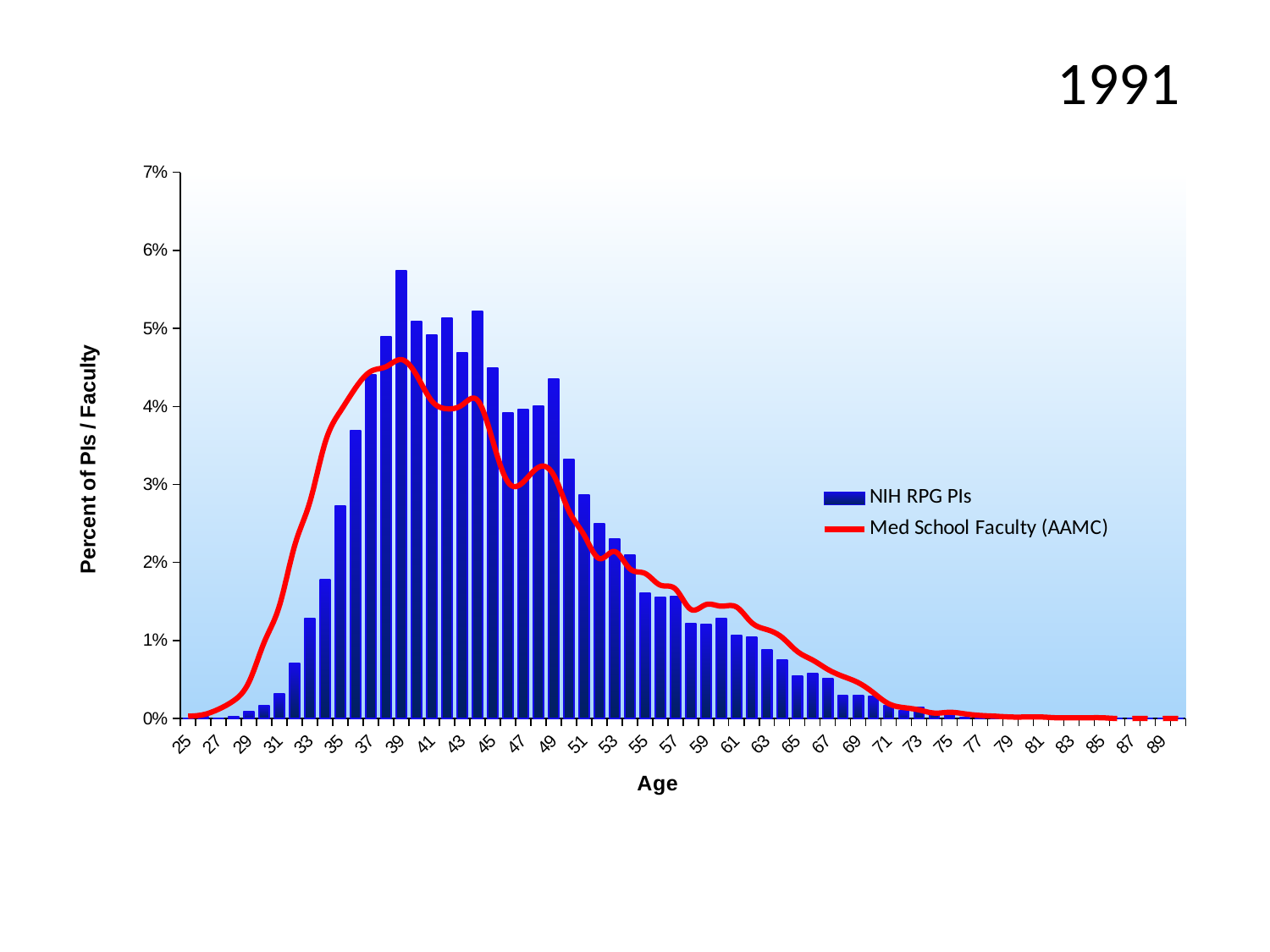
Is the NIH RPG PIs value at age 65 greater or less than 1%? less Which is larger, the NIH RPG PIs bar at age 39 or at age 49? Age 39 Is the Med School Faculty (AAMC) value at age 31 greater or less than 2%? less Do the NIH RPG PIs values rise or fall from age 49 to age 69? Fall At which age is the NIH RPG PIs bar highest? 39 What is the title of the x axis? Age How many series does the legend list? 2 Is the NIH RPG PIs value at age 35 greater or less than 3%? less Which is larger, the NIH RPG PIs bar at age 35 or at age 45? Age 45 What kind of chart is shown on the slide? Bar chart with a line overlay What are the two series named in the legend? NIH RPG PIs and Med School Faculty (AAMC)